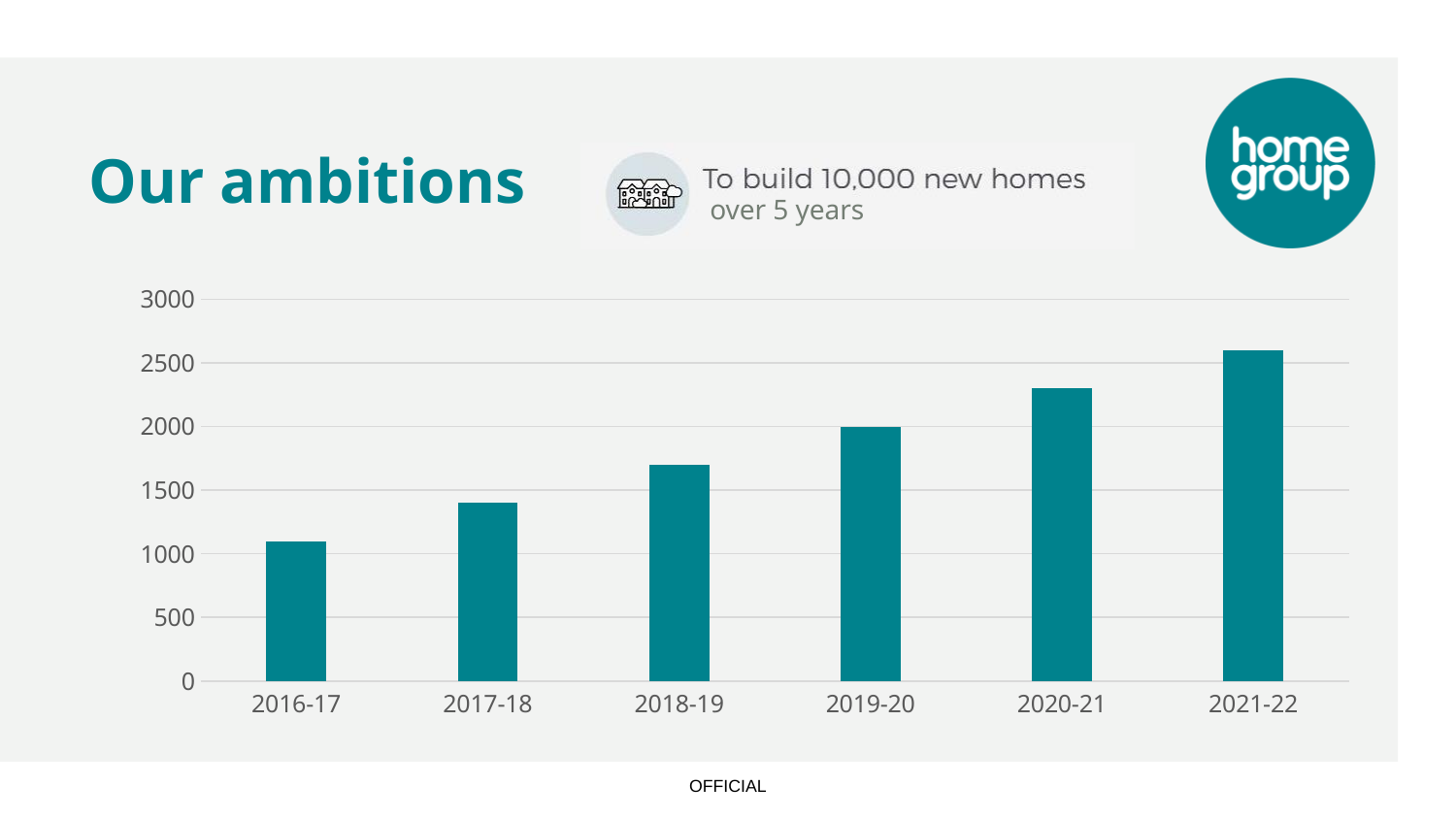
How many categories (years) are shown on the x axis of the chart? 6 Is the value for 2016-17 greater or less than 1500? less Is the value for 2020-21 greater or less than 2000? greater Which year has the highest bar in the chart? 2021-22 Is the value for 2017-18 greater or less than 1000? greater What kind of chart is shown on the slide? bar chart Do the values rise or fall from 2016-17 to 2021-22? rise What is the highest value shown on the y axis of the chart? 3000 Which is larger, the value for 2019-20 or the value for 2017-18? 2019-20 Which year has the lowest bar in the chart? 2016-17